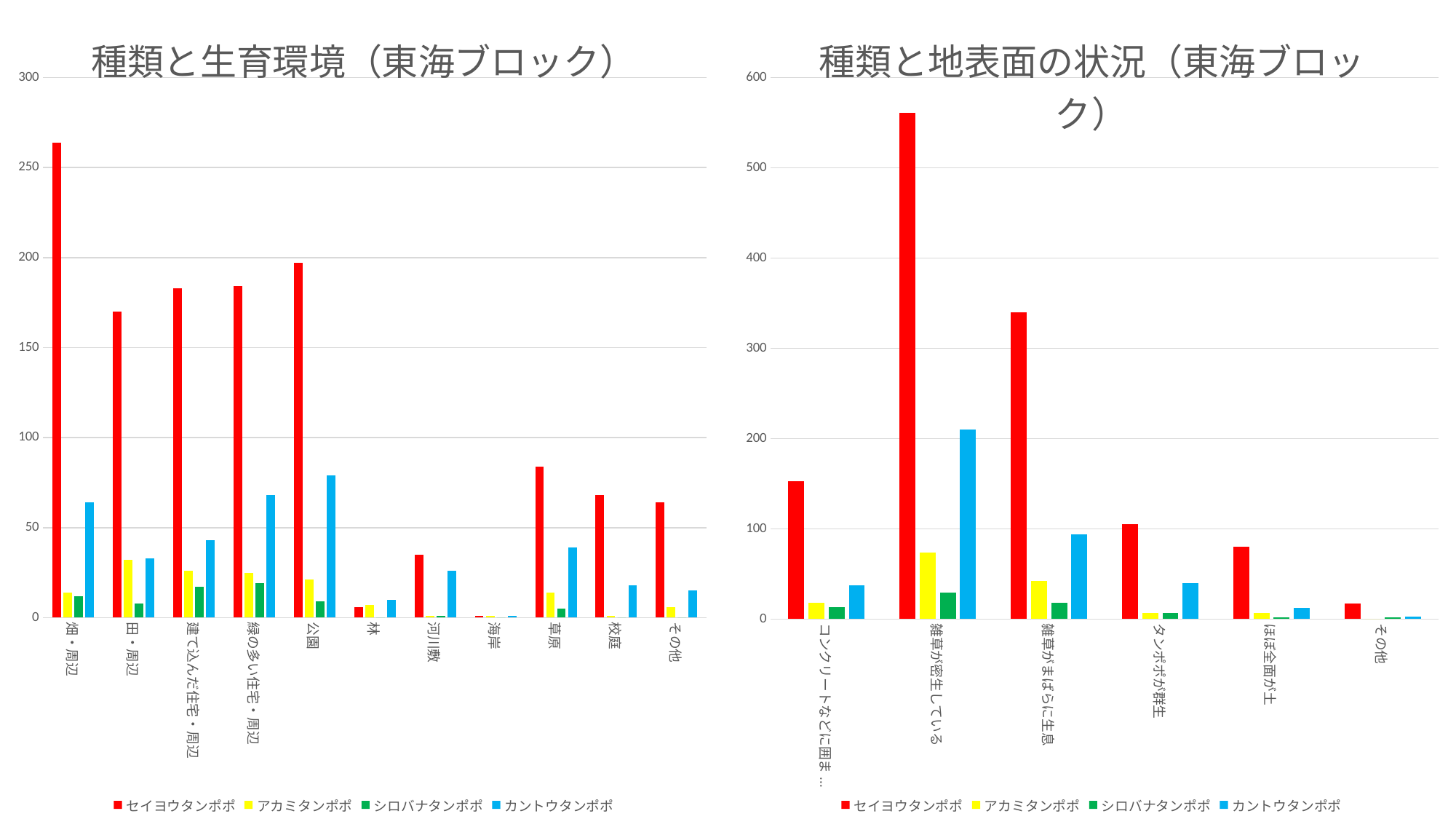
In the right chart 種類と地表面の状況（東海ブロック）, is the value for セイヨウタンポポ at 雑草がまばらに生息 greater or less than 300? greater In the right chart 種類と地表面の状況（東海ブロック）, which category has the highest value for セイヨウタンポポ? 雑草が密生している In the left chart 種類と生育環境（東海ブロック）, is the value for セイヨウタンポポ at 畑・周辺 greater or less than 250? greater What kind of chart is the left chart titled 種類と生育環境（東海ブロック）? bar chart In the left chart 種類と生育環境（東海ブロック）, which category has the highest value for セイヨウタンポポ? 畑・周辺 In the left chart 種類と生育環境（東海ブロック）, is the value for カントウタンポポ at 公園 greater or less than 100? less In the left chart 種類と生育環境（東海ブロック）, which is larger for セイヨウタンポポ: 公園 or 林? 公園 Which series is shown in red in the legend of the left chart 種類と生育環境（東海ブロック）? セイヨウタンポポ How many series does the legend of the right chart 種類と地表面の状況（東海ブロック）list? 4 In the left chart 種類と生育環境（東海ブロック）, how many categories are shown on the x axis? 11 In the right chart 種類と地表面の状況（東海ブロック）, how many categories are shown on the x axis? 6 In the right chart 種類と地表面の状況（東海ブロック）, which is larger for カントウタンポポ: 雑草が密生している or コンクリートなどに囲ま…? 雑草が密生している